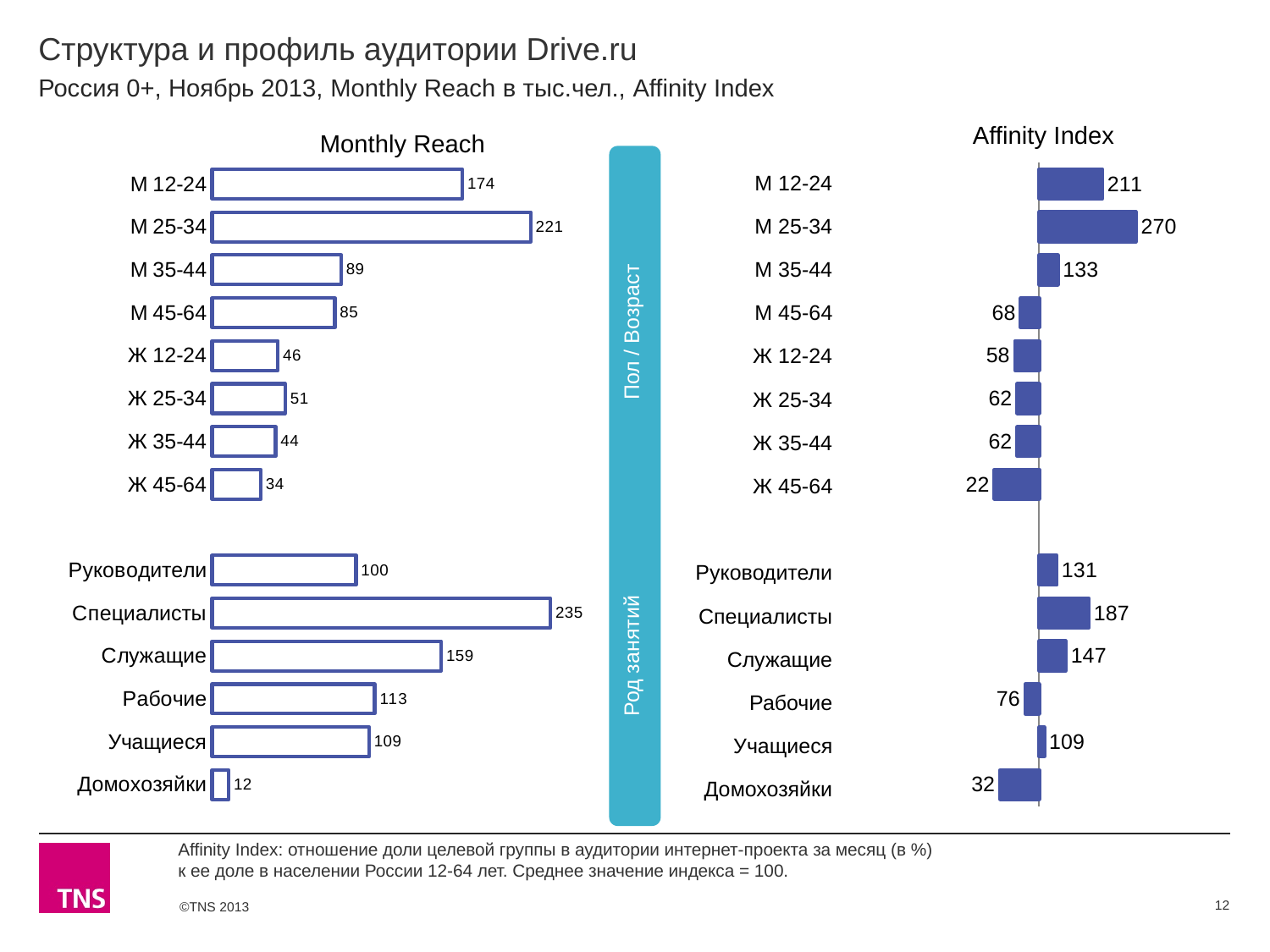
On the Affinity Index chart, what is the difference between the values for М 25-34 and М 12-24? 59 On the Affinity Index chart, what is the value for Специалисты? 187 On the Monthly Reach chart, what is the difference between the values for М 12-24 and М 35-44? 85 How many categories are shown on the Monthly Reach chart? 14 On the Affinity Index chart, which is larger: the value for Руководители or the value for Служащие? Служащие On the Affinity Index chart, which category has the lowest value? Ж 45-64 On the Affinity Index chart, what is the value for Ж 12-24? 58 What kind of chart is the Affinity Index chart? Bar chart On the Monthly Reach chart, what is the value for Домохозяйки? 12 On the Monthly Reach chart, which is larger: the value for Рабочие or the value for Учащиеся? Рабочие On the Monthly Reach chart, what is the value for М 25-34? 221 On the Monthly Reach chart, which category has the highest value? Специалисты